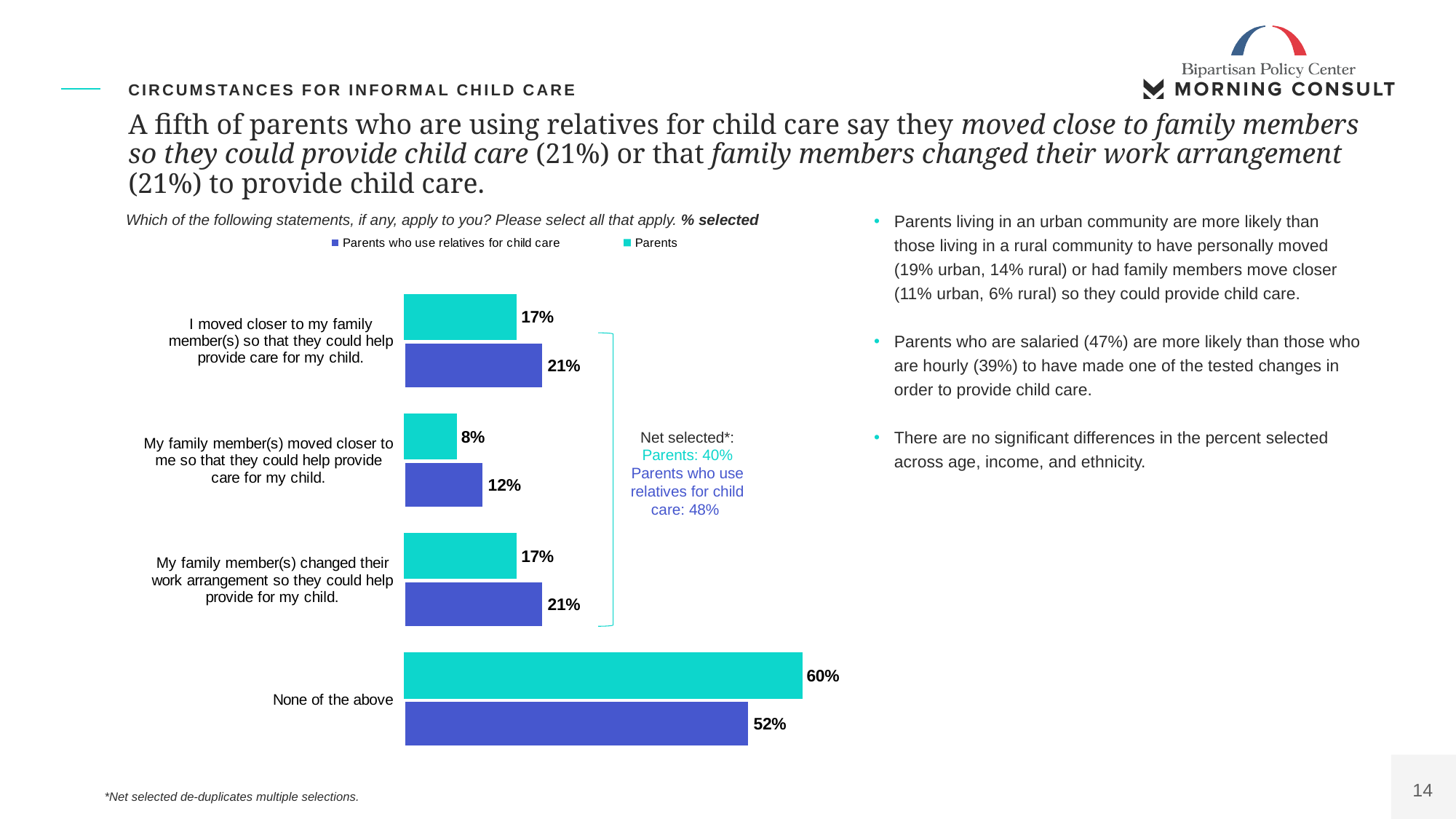
Which category has the highest value for the Parents series? None of the above What percentage of all parents selected "My family member(s) moved closer to me so that they could help provide care for my child"? 8% What is the difference between the Parents who use relatives for child care value and the Parents value for "My family member(s) moved closer to me so that they could help provide care for my child"? 4% How many series does the chart legend list? 2 How many categories (statements) are plotted on the chart? 4 What percentage of parents who use relatives for child care selected "None of the above"? 52% For "My family member(s) changed their work arrangement so they could help provide for my child", which series has the larger value: Parents or Parents who use relatives for child care? Parents who use relatives for child care What is the difference between the Parents value and the Parents who use relatives for child care value for "None of the above"? 8% Which category has the lowest value for the Parents who use relatives for child care series? My family member(s) moved closer to me so that they could help provide care for my child. Which colour represents the Parents series in the chart? Teal What kind of chart is shown on the slide? Bar chart What percentage of parents who use relatives for child care selected "I moved closer to my family member(s) so that they could help provide care for my child"? 21%